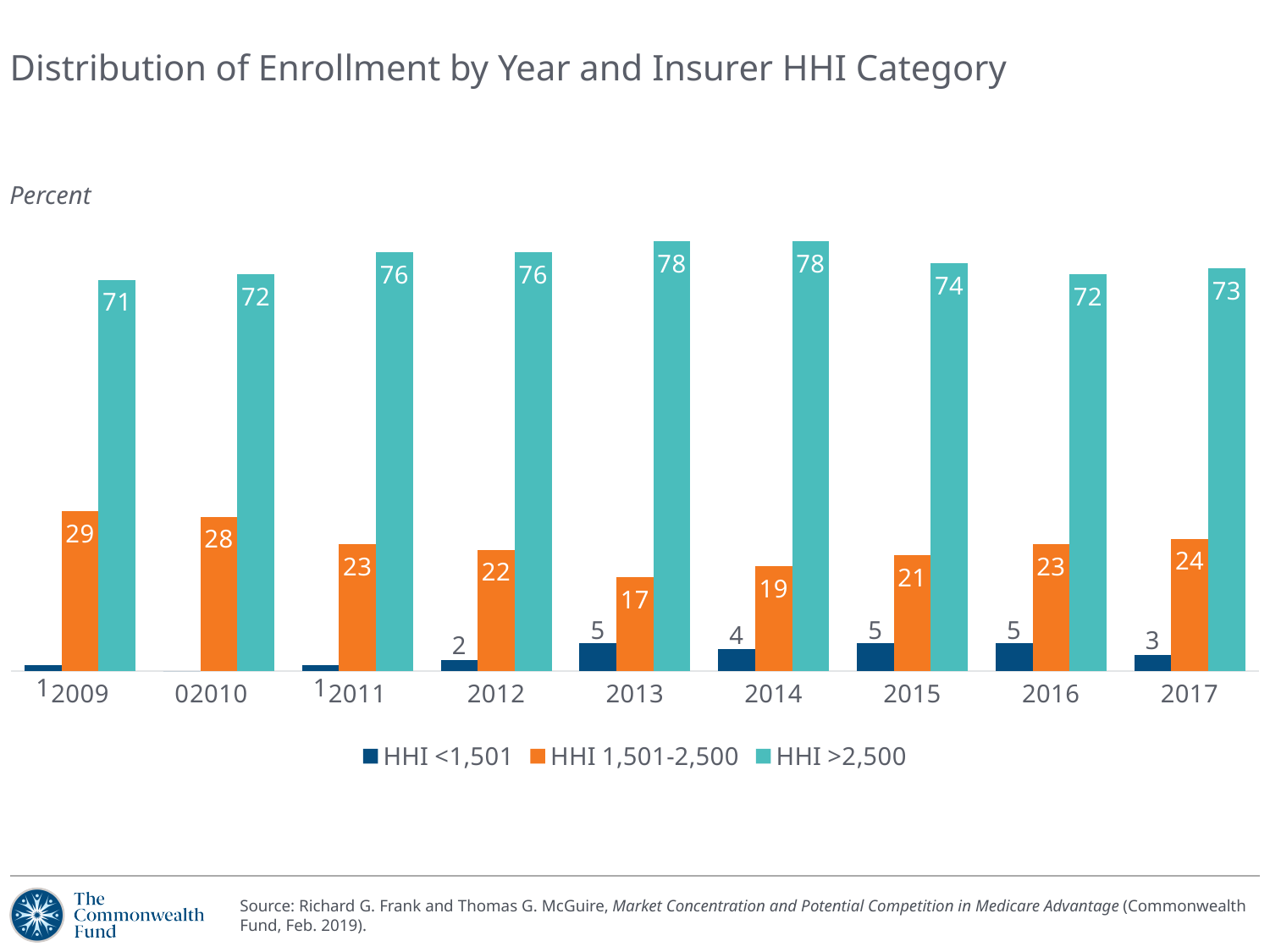
What is the value for HHI >2,500 in 2013? 78 What is the title of the chart? Distribution of Enrollment by Year and Insurer HHI Category What is the value for HHI 1,501-2,500 in 2009? 29 How many years are shown on the x axis? 9 What is the difference between the HHI >2,500 values in 2014 and 2009? 7 In which year is the HHI 1,501-2,500 value highest? 2009 What is the value for HHI <1,501 in 2015? 5 What kind of chart is shown on the slide? Bar chart Does the HHI 1,501-2,500 value rise or fall from 2009 to 2013? Fall Which is larger, the HHI 1,501-2,500 value in 2016 or in 2017? 2017 In which year is the HHI 1,501-2,500 value lowest? 2013 How many series does the legend list? 3